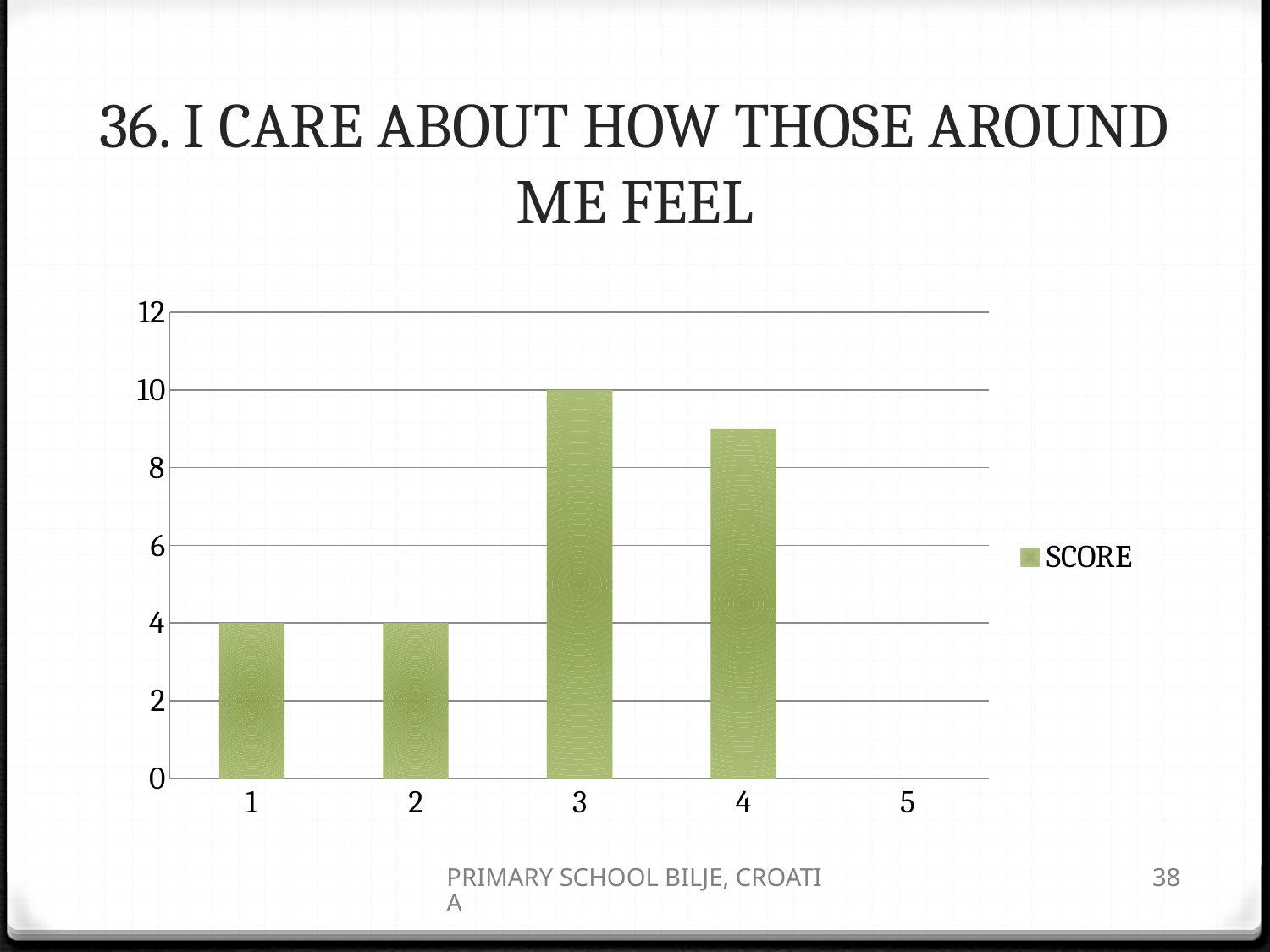
Which has the larger value, category 3 or category 4? 3 What is the value for category 1? 4 What kind of chart is shown on the slide? bar chart Which category has the highest value? 3 Is the value for category 4 greater or less than 8? greater How many categories are shown on the x axis? 5 What is the name of the series shown in the legend? SCORE Which category has the lowest value? 5 What is the value for category 2? 4 How many series does the legend list? 1 What is the value for category 3? 10 What is the difference between the values for category 3 and category 1? 6